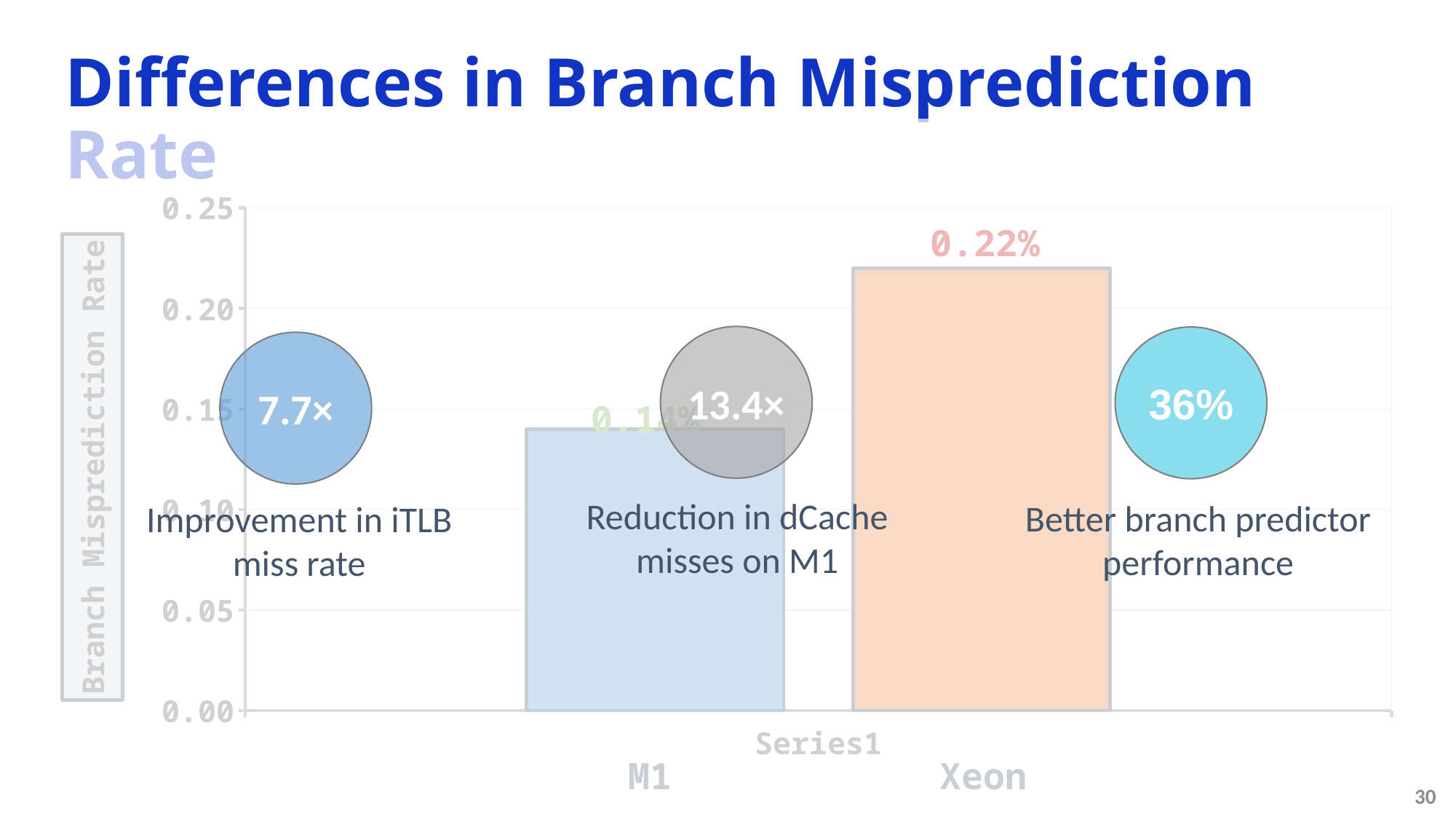
Is the value for M1 greater or less than 0.15? less Which processor has the lower branch misprediction rate in the chart? M1 Is the branch misprediction rate for M1 larger or smaller than that for Xeon? smaller What is the difference between the Xeon and M1 branch misprediction rates? 0.08% How many bars are plotted in the chart? 2 Is the value for Xeon greater or less than 0.20? greater What is the maximum value shown on the y axis of the chart? 0.25 What is the branch misprediction rate shown for M1? 0.14% What is the branch misprediction rate shown for Xeon? 0.22% Which processor has the higher branch misprediction rate in the chart? Xeon What kind of chart is shown on the slide? bar chart What is the title of the slide? Differences in Branch Misprediction Rate